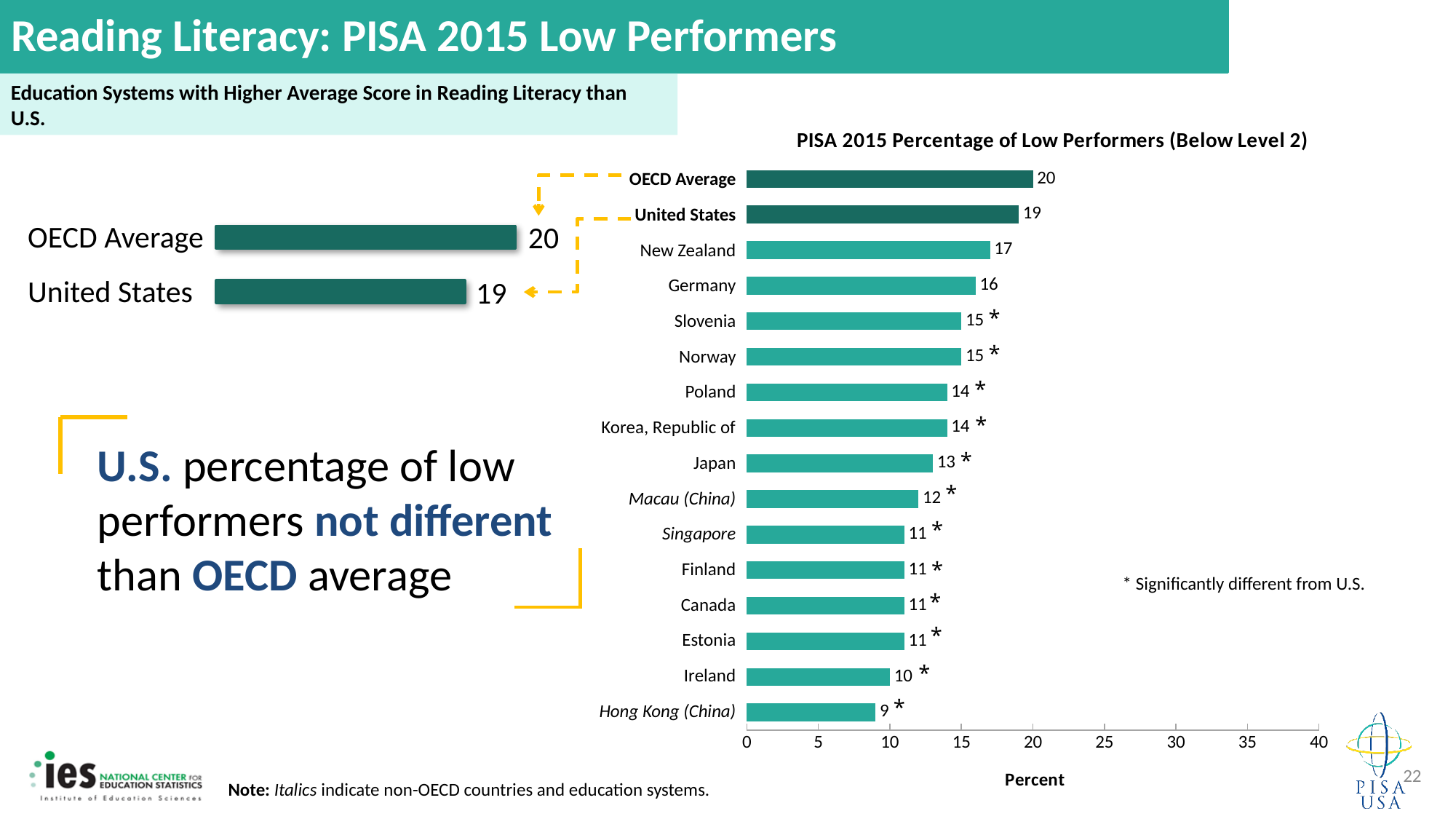
In the small chart on the left of the slide, what is the difference between the values for OECD Average and United States? 1 In the chart titled 'PISA 2015 Percentage of Low Performers (Below Level 2)', what is the value for Germany? 16 What kind of chart is the chart titled 'PISA 2015 Percentage of Low Performers (Below Level 2)'? Bar chart In the chart titled 'PISA 2015 Percentage of Low Performers (Below Level 2)', what is the value for New Zealand? 17 In the chart titled 'PISA 2015 Percentage of Low Performers (Below Level 2)', which category has the highest value? OECD Average In the chart titled 'PISA 2015 Percentage of Low Performers (Below Level 2)', which is larger, the value for Ireland or the value for Macau (China)? Macau (China) In the chart titled 'PISA 2015 Percentage of Low Performers (Below Level 2)', what is the label of the horizontal axis? Percent In the chart titled 'PISA 2015 Percentage of Low Performers (Below Level 2)', which category has the lowest value? Hong Kong (China) In the small chart on the left of the slide, what is the value for United States? 19 In the chart titled 'PISA 2015 Percentage of Low Performers (Below Level 2)', what is the difference between the values for OECD Average and Hong Kong (China)? 11 In the chart titled 'PISA 2015 Percentage of Low Performers (Below Level 2)', what is the value for Japan? 13 In the chart titled 'PISA 2015 Percentage of Low Performers (Below Level 2)', how many categories are plotted? 16